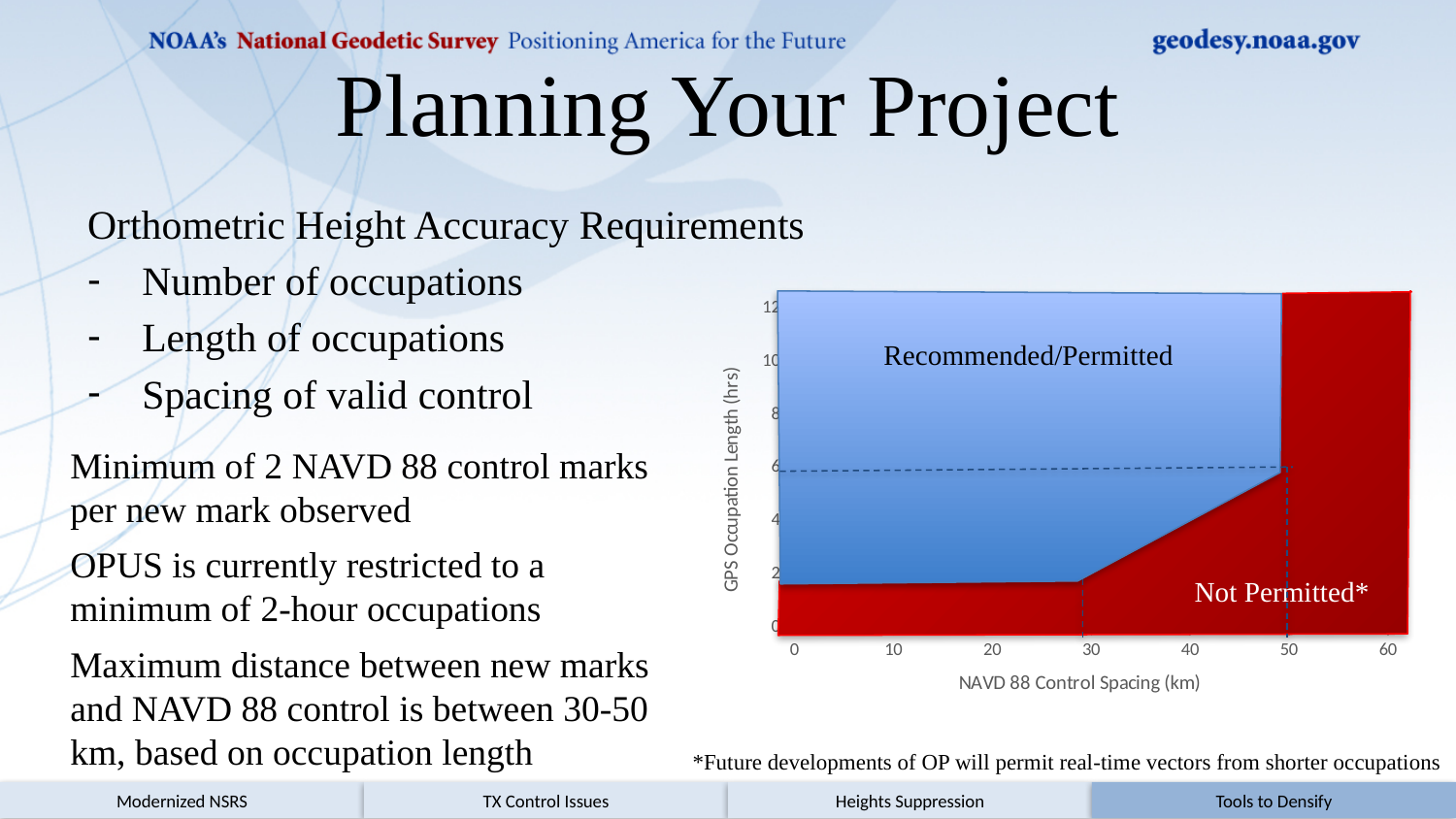
What is the label of the x axis of the chart? NAVD 88 Control Spacing (km) What kind of chart is shown on the slide? area chart What is the red region of the chart labelled? Not Permitted* Is the minimum occupation length at 40 km spacing greater or less than 2 hrs? greater What is the label of the y axis of the chart? GPS Occupation Length (hrs) Is the minimum occupation length at 40 km spacing greater or less than 6 hrs? less According to the chart, what is the minimum GPS occupation length at a NAVD 88 control spacing of 30 km? 2 hrs Between 30 km and 50 km of control spacing, does the boundary of the permitted region rise or fall? rise What is the highest value shown on the y axis of the chart? 12 What is the blue region of the chart labelled? Recommended/Permitted According to the chart, what is the minimum GPS occupation length at a NAVD 88 control spacing of 50 km? 6 hrs Which requires a longer minimum occupation: a control spacing of 30 km or 50 km? 50 km